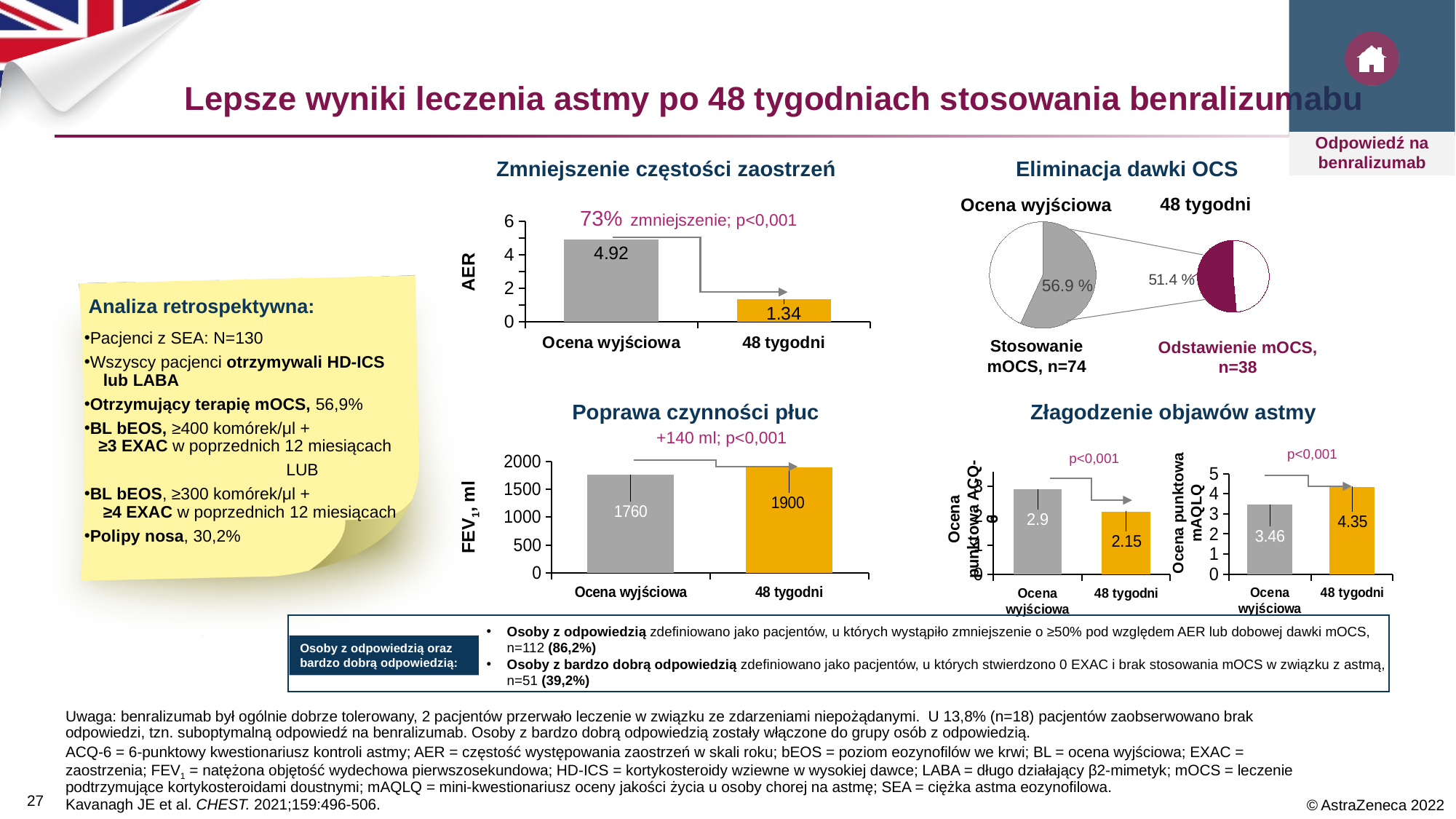
In the 'Poprawa czynności płuc' chart, what is the FEV1 value at Ocena wyjściowa? 1760 In the 'Zmniejszenie częstości zaostrzeń' chart, what is the difference between the AER at Ocena wyjściowa and at 48 tygodni? 3.58 In the 'Eliminacja dawki OCS' section, what percentage is shown in the 48 tygodni pie chart? 51.4 % In the 'Złagodzenie objawów astmy' section, which is larger for mAQLQ: Ocena wyjściowa or 48 tygodni? 48 tygodni In the 'Eliminacja dawki OCS' section, what percentage is shown in the Ocena wyjściowa pie chart? 56.9 % In the 'Poprawa czynności płuc' chart, what is the FEV1 value at 48 tygodni? 1900 In the 'Zmniejszenie częstości zaostrzeń' chart, what is the AER value at Ocena wyjściowa? 4.92 In the 'Poprawa czynności płuc' chart, do the values rise or fall from Ocena wyjściowa to 48 tygodni? rise In the 'Złagodzenie objawów astmy' section, what is the ACQ-6 score at 48 tygodni? 2.15 In the 'Zmniejszenie częstości zaostrzeń' chart, what is the AER value at 48 tygodni? 1.34 In the 'Złagodzenie objawów astmy' section, what is the mAQLQ score at Ocena wyjściowa? 3.46 What kind of chart is used in the 'Zmniejszenie częstości zaostrzeń' panel? bar chart